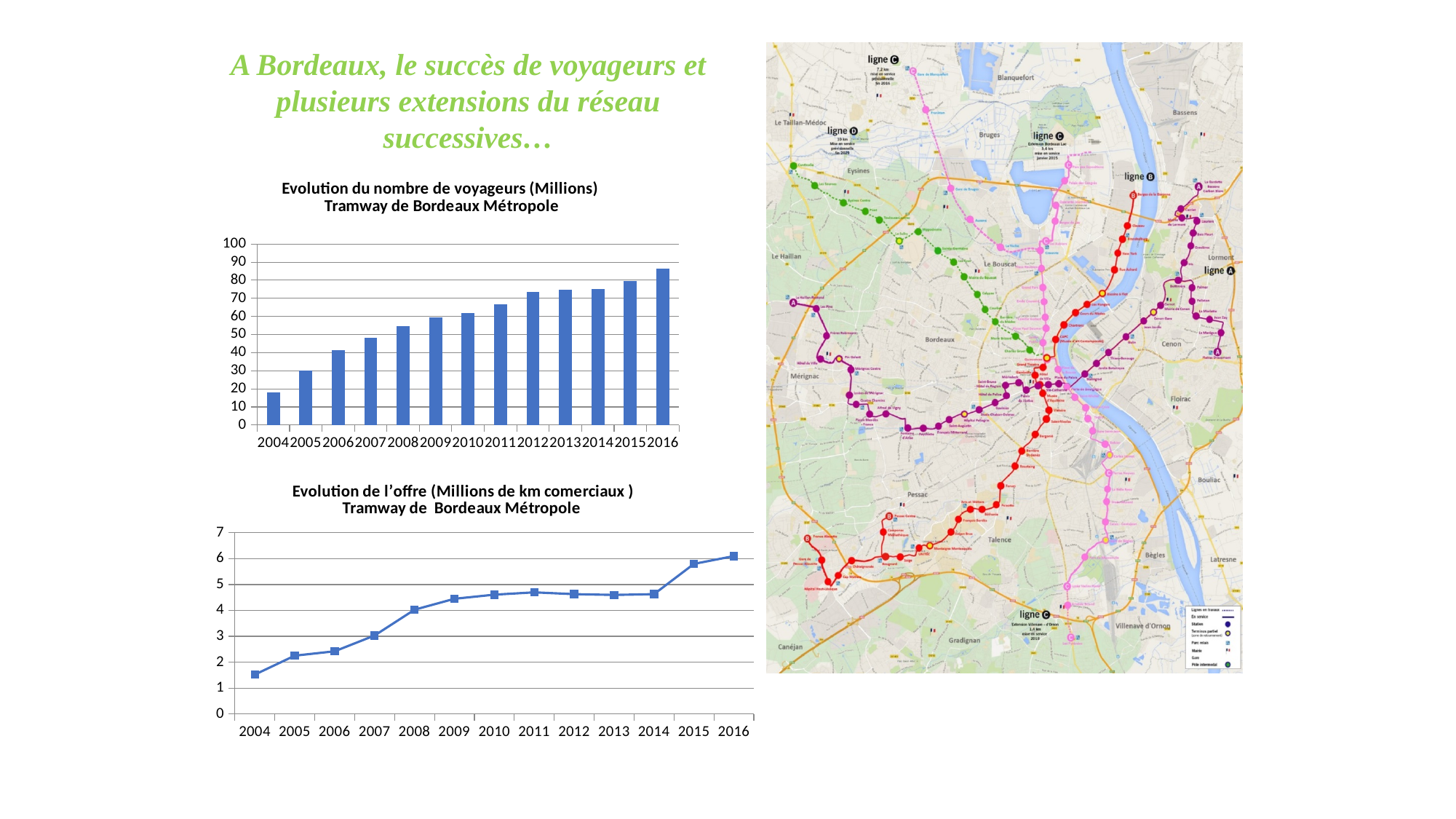
How many years are shown on the x axis of the 'Evolution du nombre de voyageurs' chart? 13 In the 'Evolution du nombre de voyageurs' chart, is the value for 2004 greater or less than 20? less In the 'Evolution du nombre de voyageurs' chart, is the value for 2016 greater or less than 80? greater In the 'Evolution du nombre de voyageurs' chart, which year has the lowest value? 2004 In the 'Evolution de l'offre' chart, which year has the highest value? 2016 What kind of chart is the 'Evolution du nombre de voyageurs (Millions)' chart? bar chart What kind of chart is the 'Evolution de l'offre (Millions de km comerciaux)' chart? line chart In the 'Evolution du nombre de voyageurs' chart, which year has the highest value? 2016 In the 'Evolution de l'offre' chart, which year has the lowest value? 2004 In the 'Evolution du nombre de voyageurs' chart, do the values generally rise or fall from 2004 to 2016? rise In the 'Evolution de l'offre' chart, which is larger, the value for 2015 or the value for 2014? 2015